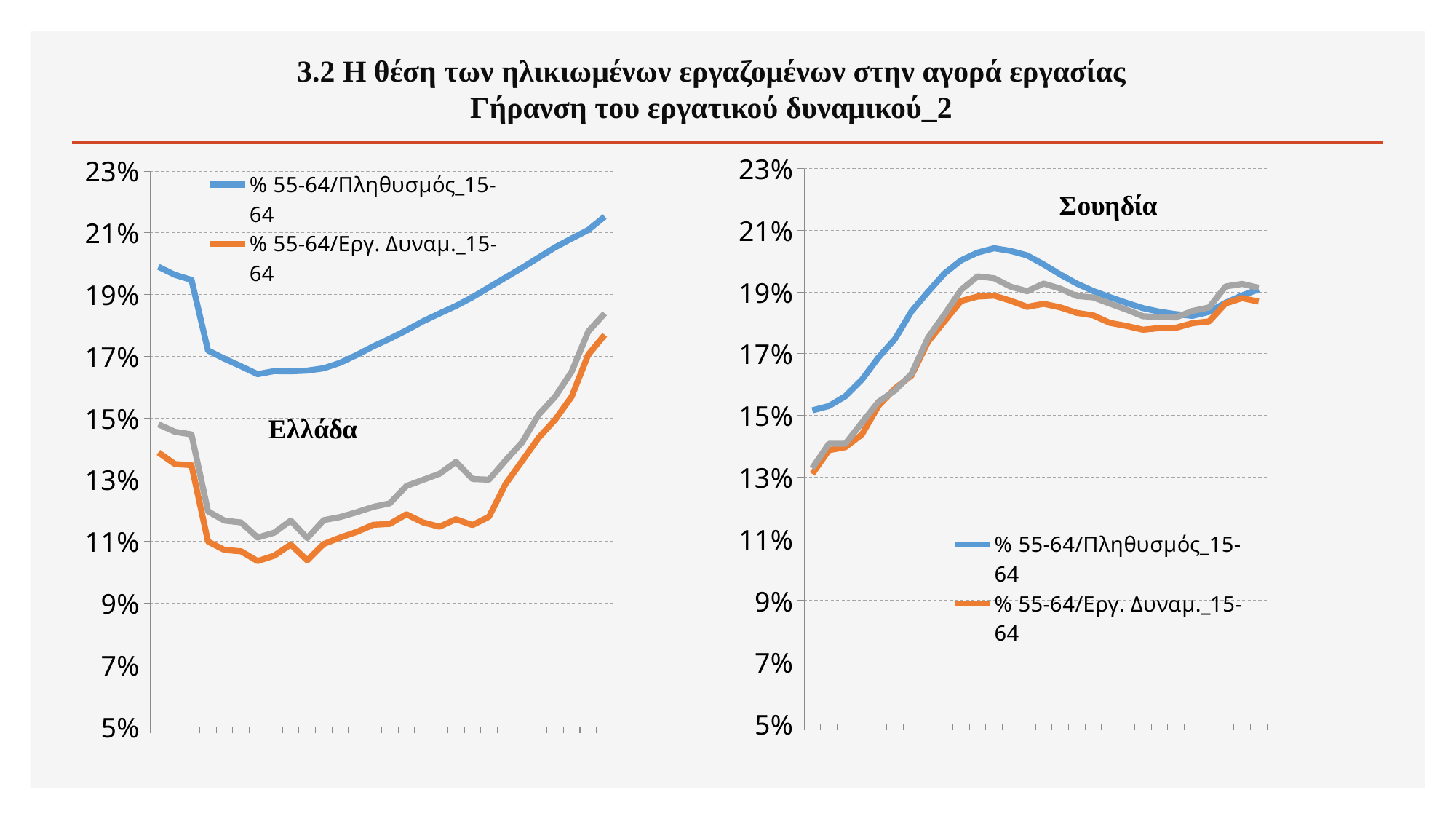
In the Σουηδία chart, does the blue line rise or fall from its first point to its peak? rise What is the highest value shown on the y axis of the Ελλάδα chart? 23% In the Σουηδία chart, is the lowest point of the orange line after its peak greater or less than 17%? greater In the Ελλάδα chart, is the lowest point of the orange line (% 55-64/Εργ. Δυναμ._15-64) greater or less than 11%? less In the Ελλάδα chart, is the final value of the blue line (% 55-64/Πληθυσμός_15-64) greater or less than 21%? greater In the Ελλάδα chart, does the blue line end higher or lower than it starts? higher What kind of chart is the left chart labelled Ελλάδα? line chart How many series does the legend of the right chart (Σουηδία) list? 2 What country label is shown on the right chart? Σουηδία In the Ελλάδα chart, which line is higher across the whole x axis, the blue line or the orange line? the blue line